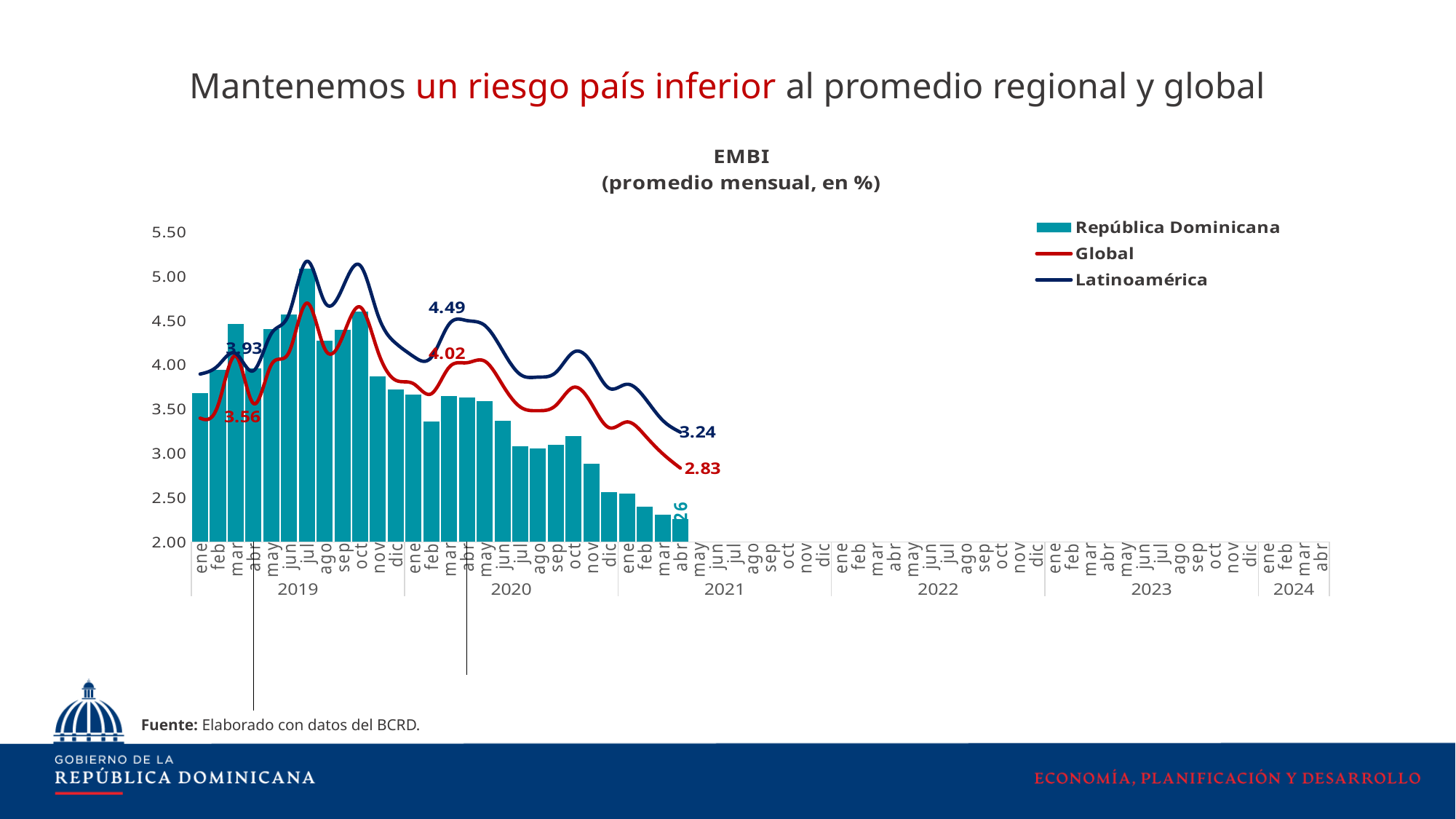
What is the labelled value of the Global line at the end of the series (April 2021)? 2.83 Do the República Dominicana bars rise or fall from the start of 2020 to April 2021? fall In April 2020, which is higher: the Latinoamérica value or the Global value? Latinoamérica How many series does the legend list? 3 What is the labelled value of the Global line in April 2020? 4.02 What kind of chart is shown on the slide? A combined bar and line chart What is the title of the chart? EMBI (promedio mensual, en %) What is the labelled value of the Latinoamérica line in April 2020? 4.49 What is the difference between the Latinoamérica and Global labelled values in April 2020? 0.47 What is the difference between the Latinoamérica and Global labelled values in April 2021? 0.41 What is the labelled value of the Latinoamérica line at the end of the series (April 2021)? 3.24 Is the República Dominicana bar for April 2021 greater or less than 2.50? less